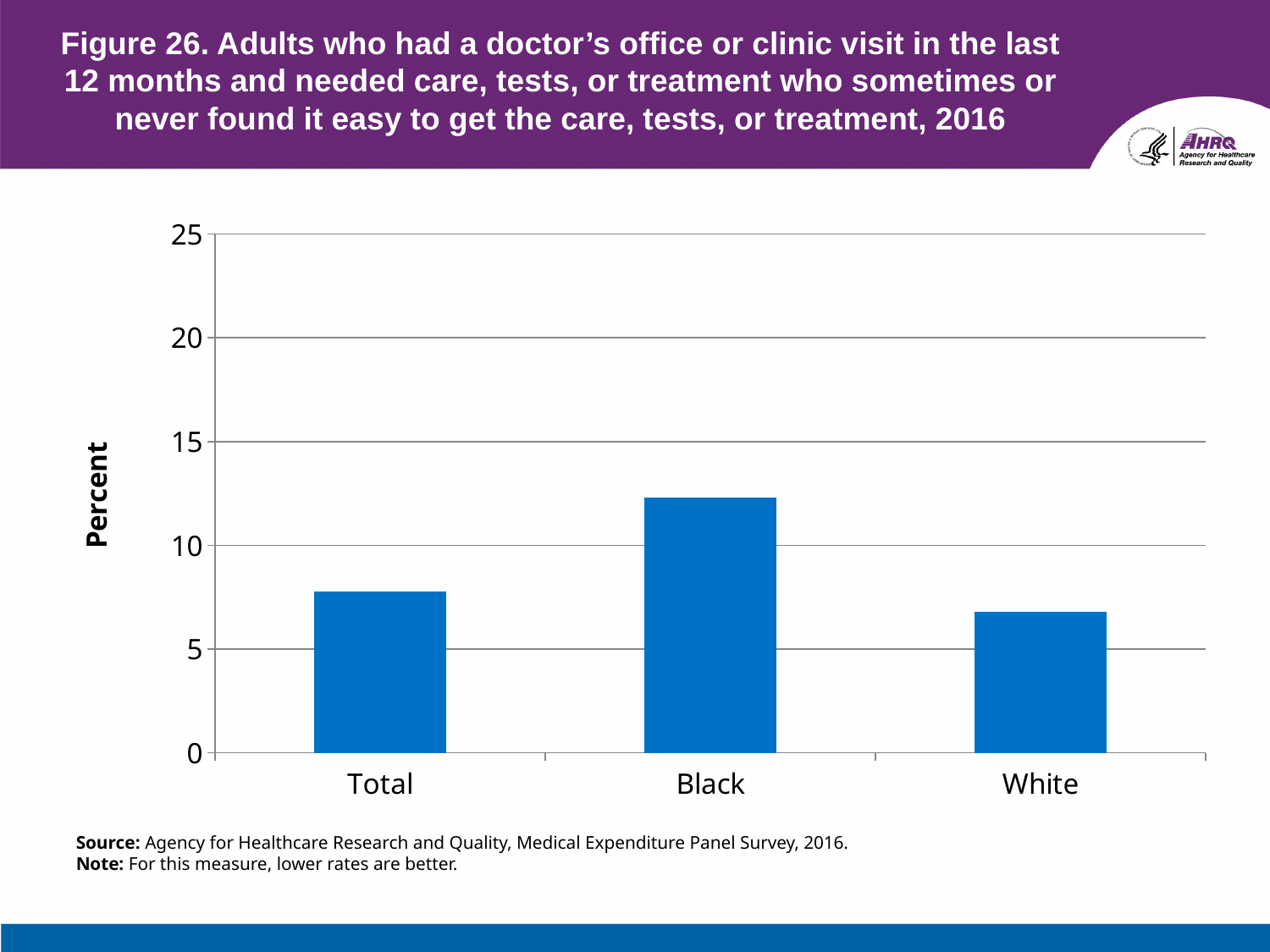
Is the value for Total greater or less than 10? less What is the label on the y axis of the chart? Percent What is the maximum value shown on the y axis of the chart? 25 How many categories are shown on the x axis of the chart? 3 Which category has the highest value in the chart? Black Which is larger, the value for Black or the value for Total? Black Which category has the lowest value in the chart? White Which is larger, the value for Black or the value for White? Black What kind of chart is shown on the slide? bar chart Is the value for Black greater or less than 15? less Is the value for White greater or less than 5? greater